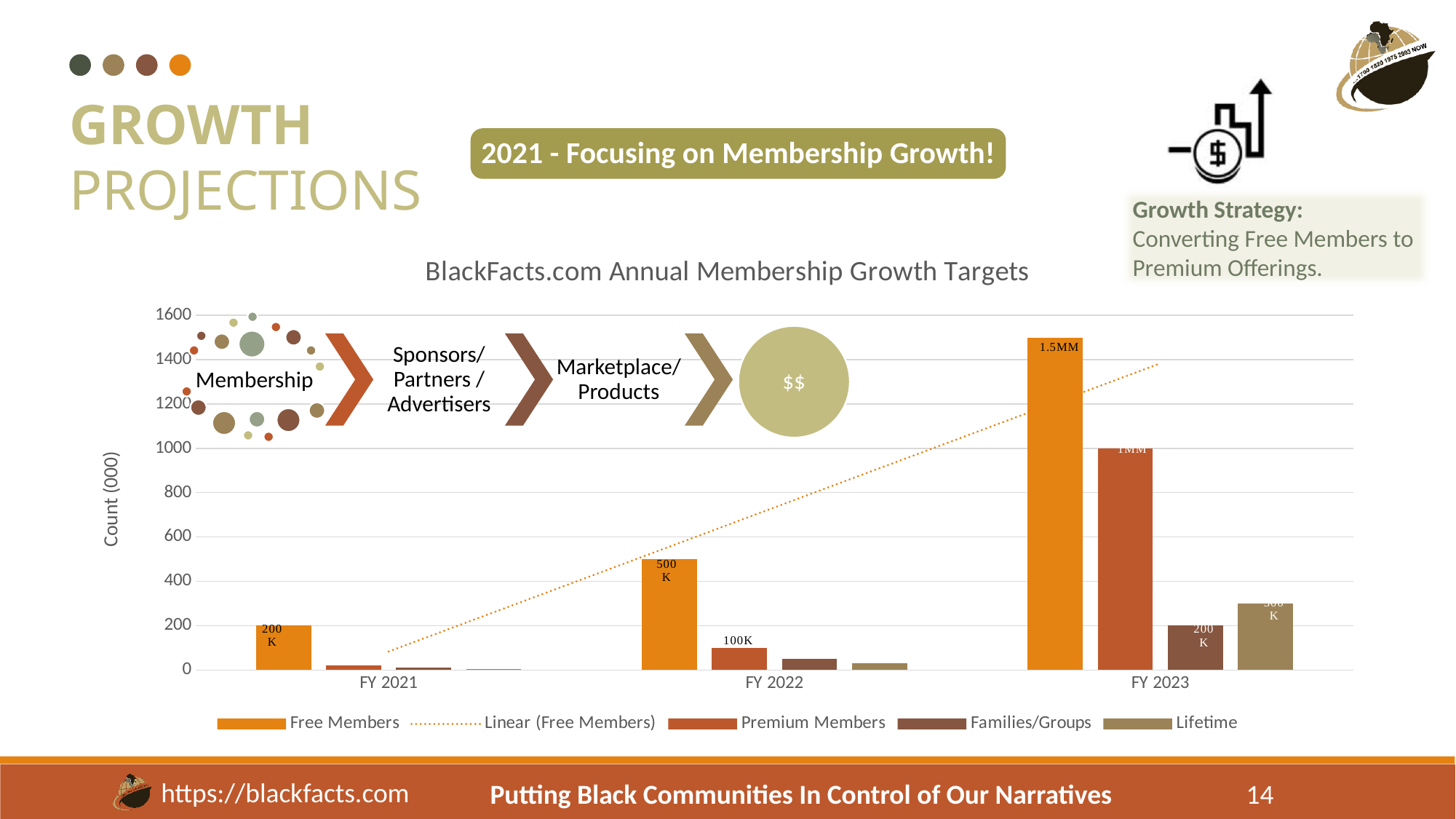
What is the Free Members value for FY 2023? 1.5MM What is the Free Members value for FY 2022? 500 K Do the Free Members values rise or fall from FY 2021 to FY 2023? rise In FY 2022, which is larger: Free Members or Premium Members? Free Members How many entries does the chart legend list? 5 What is the Free Members value for FY 2021? 200 K What is the title of the chart? BlackFacts.com Annual Membership Growth Targets What is the Premium Members value for FY 2022? 100K How many fiscal years are shown on the x axis of the chart? 3 Is the Premium Members value for FY 2023 greater or less than 800? greater What kind of chart is shown on the slide? bar chart In which fiscal year is the Free Members bar highest? FY 2023